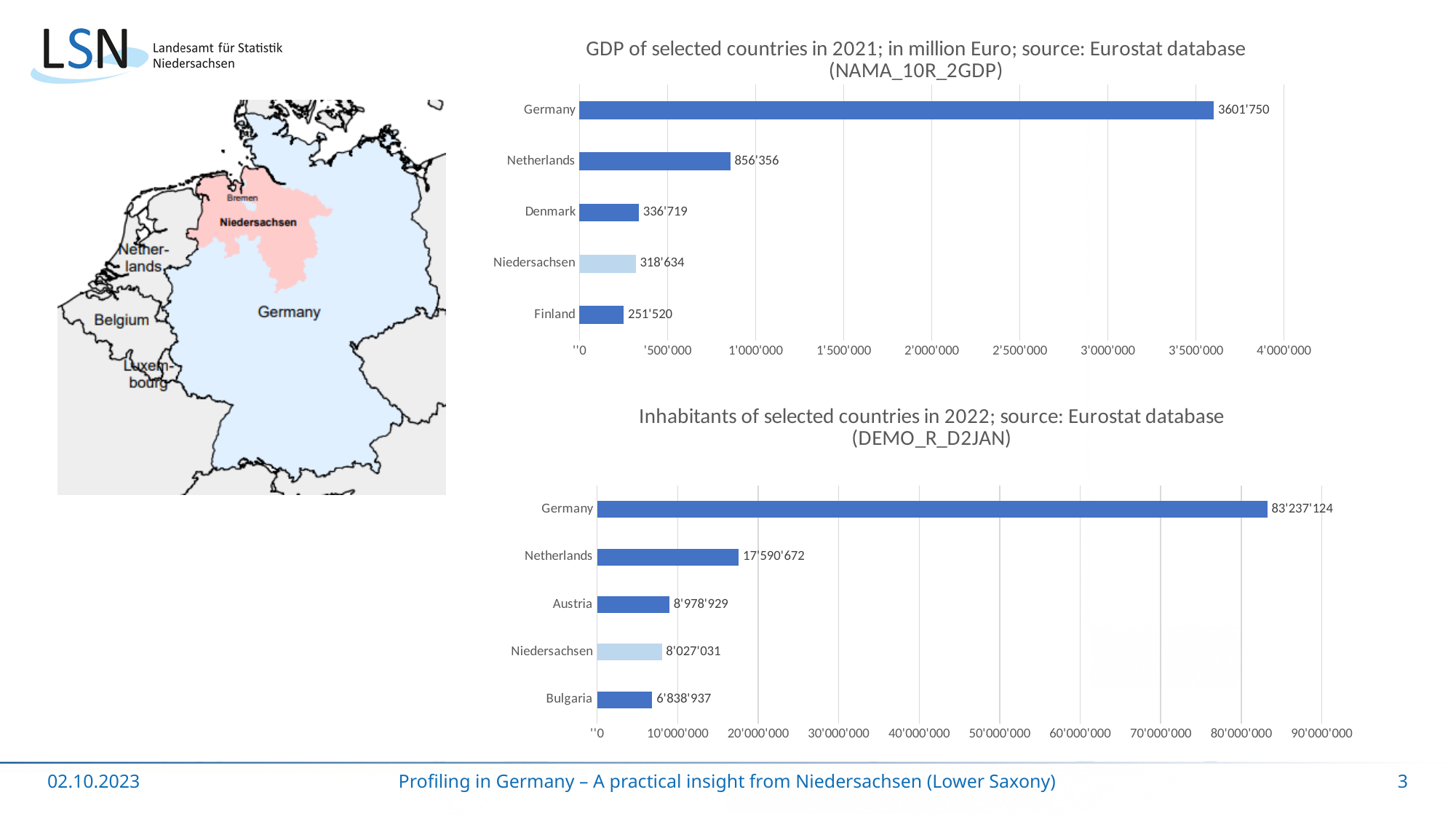
In the GDP chart, which category has the lowest value? Finland In the GDP chart, what is the value for Germany? 3601'750 What kind of chart is the Inhabitants chart? Bar chart In the GDP chart, which bar is shown in a lighter blue colour than the others? Niedersachsen In the GDP chart, what is the difference between Denmark and Niedersachsen? 18'085 In the Inhabitants chart, which is larger, Austria or Bulgaria? Austria In the GDP chart, what is the value for Niedersachsen? 318'634 In the Inhabitants chart, what is the value for Netherlands? 17'590'672 How many categories are shown in the GDP chart? 5 In the Inhabitants chart, what is the value for Bulgaria? 6'838'937 In the Inhabitants chart, which category has the highest value? Germany In the Inhabitants chart, what is the difference between Austria and Niedersachsen? 951'898